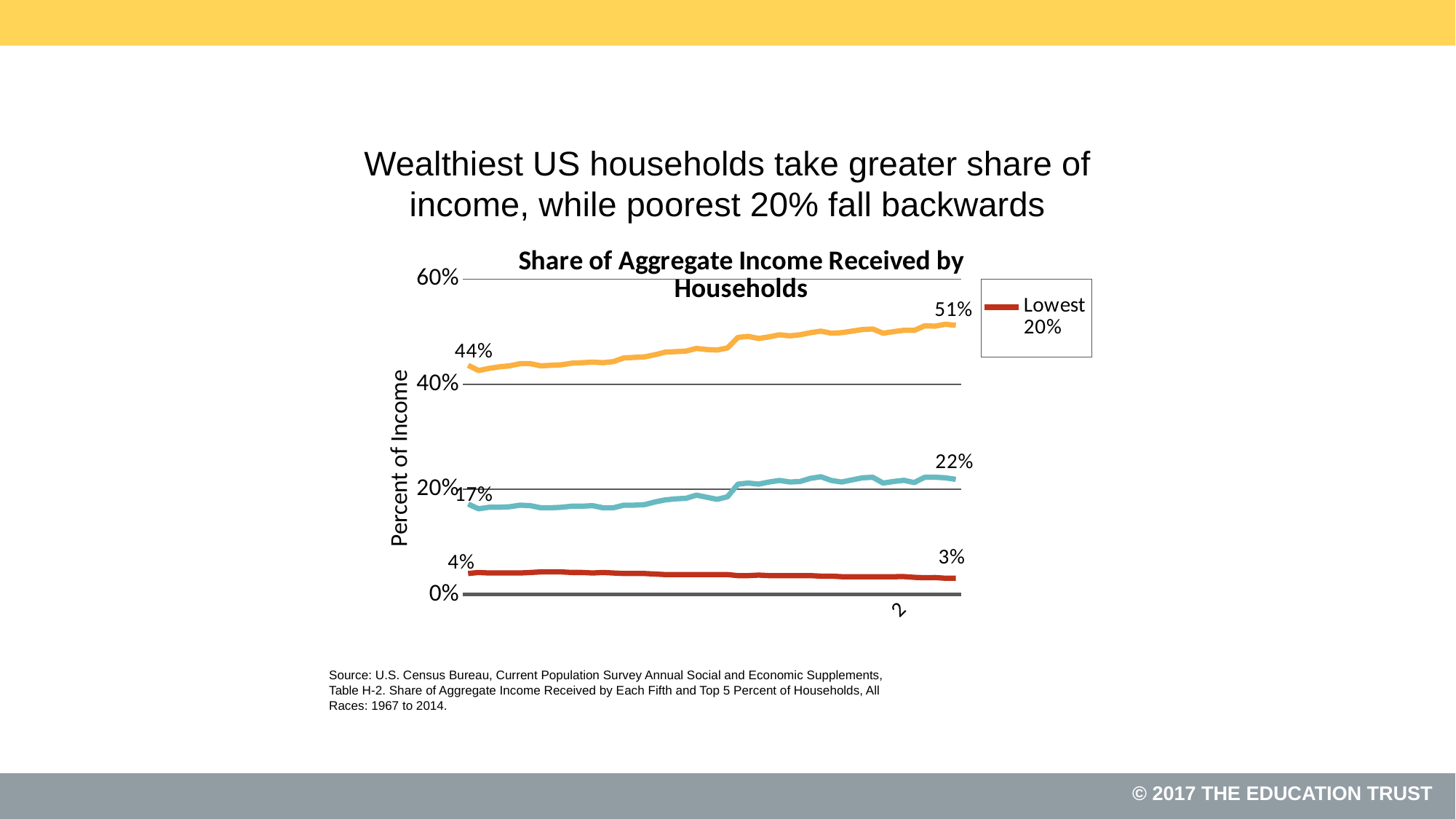
What is the value of the Lowest 20% line at the start of the series? 4% What is the value of the Lowest 20% line at the end of the series? 3% Is the end value of the orange (top) line greater or less than 40%? greater How many lines are plotted on the chart? 3 What is the value of the orange (top) line at the end of the series? 51% What is the label on the vertical axis of the chart? Percent of Income By how many percentage points does the orange (top) line change from its start value of 44% to its end value of 51%? 7 percentage points By how many percentage points does the teal (middle) line change from its start value of 17% to its end value of 22%? 5 percentage points What kind of chart is shown on the slide? Line chart What is the value of the teal (middle) line at the start of the series? 17% Does the Lowest 20% line rise or fall from the start to the end of the series? Fall What is the title of the chart? Share of Aggregate Income Received by Households